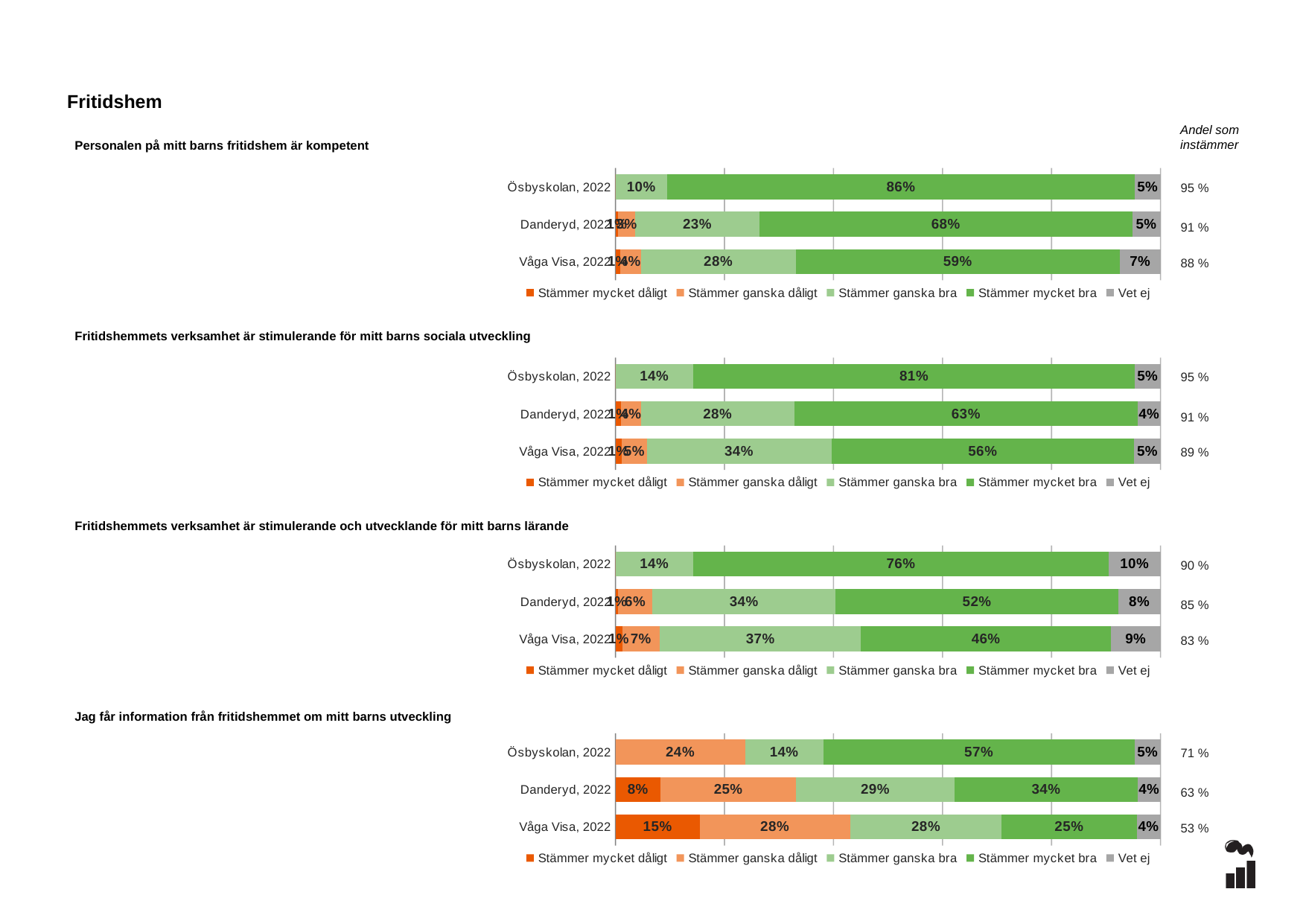
What kind of chart is used for 'Personalen på mitt barns fritidshem är kompetent'? Stacked bar chart In the chart 'Fritidshemmets verksamhet är stimulerande för mitt barns sociala utveckling', what is the difference between the 'Stämmer mycket bra' values for Ösbyskolan, 2022 and Våga Visa, 2022? 25% In the chart 'Personalen på mitt barns fritidshem är kompetent', what is the 'Stämmer ganska bra' value for Våga Visa, 2022? 28% In the chart 'Fritidshemmets verksamhet är stimulerande för mitt barns sociala utveckling', what is the 'Stämmer mycket bra' value for Danderyd, 2022? 63% In the chart 'Personalen på mitt barns fritidshem är kompetent', what is the 'Stämmer mycket bra' value for Ösbyskolan, 2022? 86% In the chart 'Fritidshemmets verksamhet är stimulerande och utvecklande för mitt barns lärande', which is larger: the 'Stämmer ganska bra' value for Danderyd, 2022 or for Våga Visa, 2022? Våga Visa, 2022 In the chart 'Personalen på mitt barns fritidshem är kompetent', which row has the highest 'Stämmer mycket bra' value? Ösbyskolan, 2022 How many series does the legend list for the chart 'Jag får information från fritidshemmet om mitt barns utveckling'? 5 In the chart 'Fritidshemmets verksamhet är stimulerande och utvecklande för mitt barns lärande', what is the 'Vet ej' value for Ösbyskolan, 2022? 10% In the chart 'Jag får information från fritidshemmet om mitt barns utveckling', what is the difference between the 'Stämmer ganska dåligt' values for Danderyd, 2022 and Ösbyskolan, 2022? 1% In the chart 'Jag får information från fritidshemmet om mitt barns utveckling', which row has the lowest 'Stämmer mycket bra' value? Våga Visa, 2022 In the chart 'Jag får information från fritidshemmet om mitt barns utveckling', what is the 'Stämmer mycket dåligt' value for Våga Visa, 2022? 15%